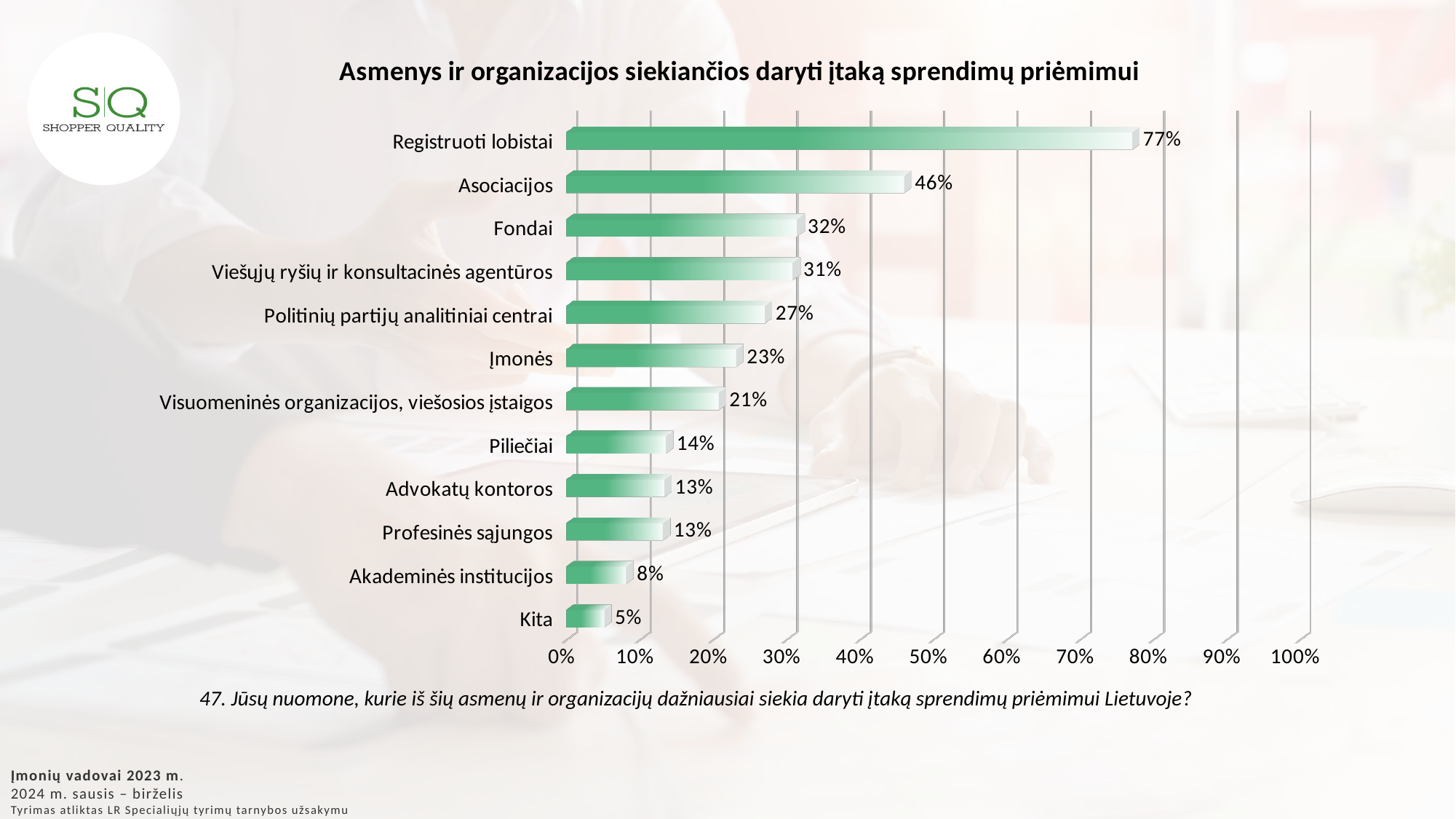
What is the difference between the values for Registruoti lobistai and Asociacijos? 31% What kind of chart is shown on the slide? Bar chart What is the value for Akademinės institucijos? 8% Which category has the lowest value? Kita What is the value for Registruoti lobistai? 77% What is the value for Asociacijos? 46% What is the title of the chart? Asmenys ir organizacijos siekiančios daryti įtaką sprendimų priėmimui Which is larger, the value for Fondai or the value for Įmonės? Fondai How many categories are shown in the chart? 12 What is the difference between the values for Piliečiai and Kita? 9% What is the value for Viešųjų ryšių ir konsultacinės agentūros? 31% Which category has the highest value? Registruoti lobistai